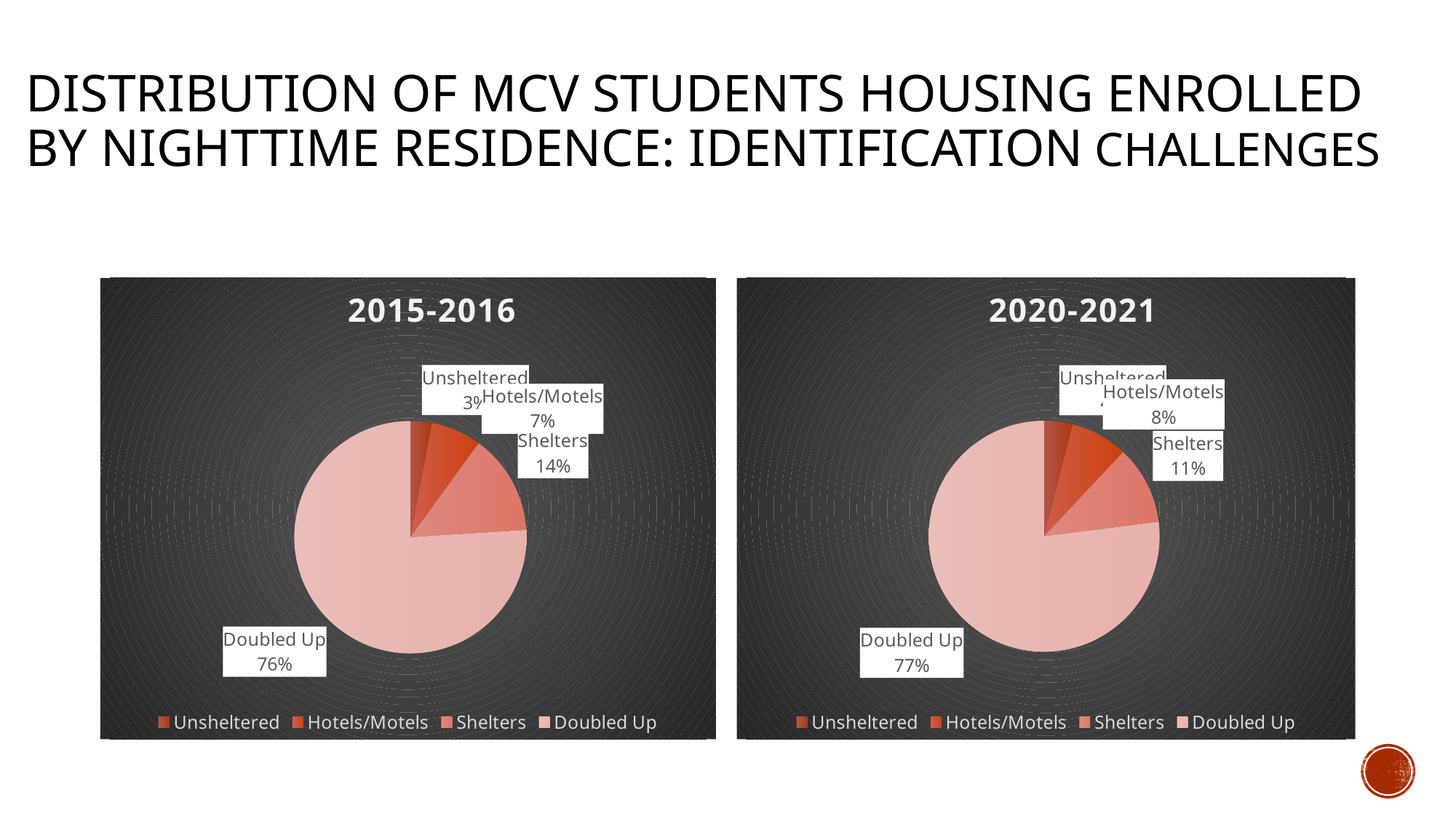
In the 2020-2021 pie chart, what share is Shelters? 11% In the 2020-2021 pie chart, what share is Doubled Up? 77% In the 2015-2016 pie chart, what is the difference between the Shelters share and the Hotels/Motels share? 7% In the 2015-2016 pie chart, what share is Doubled Up? 76% In the 2020-2021 pie chart, what share is Hotels/Motels? 8% What type of chart is used for 2015-2016? Pie chart Which is larger: the Shelters share in 2015-2016 or the Shelters share in 2020-2021? 2015-2016 What is the title of the chart on the right? 2020-2021 In the 2015-2016 pie chart, which category has the largest share? Doubled Up In the 2020-2021 pie chart, which category has the smallest share? Unsheltered How many categories does the 2020-2021 pie chart show? 4 In the 2015-2016 pie chart, what share is Shelters? 14%